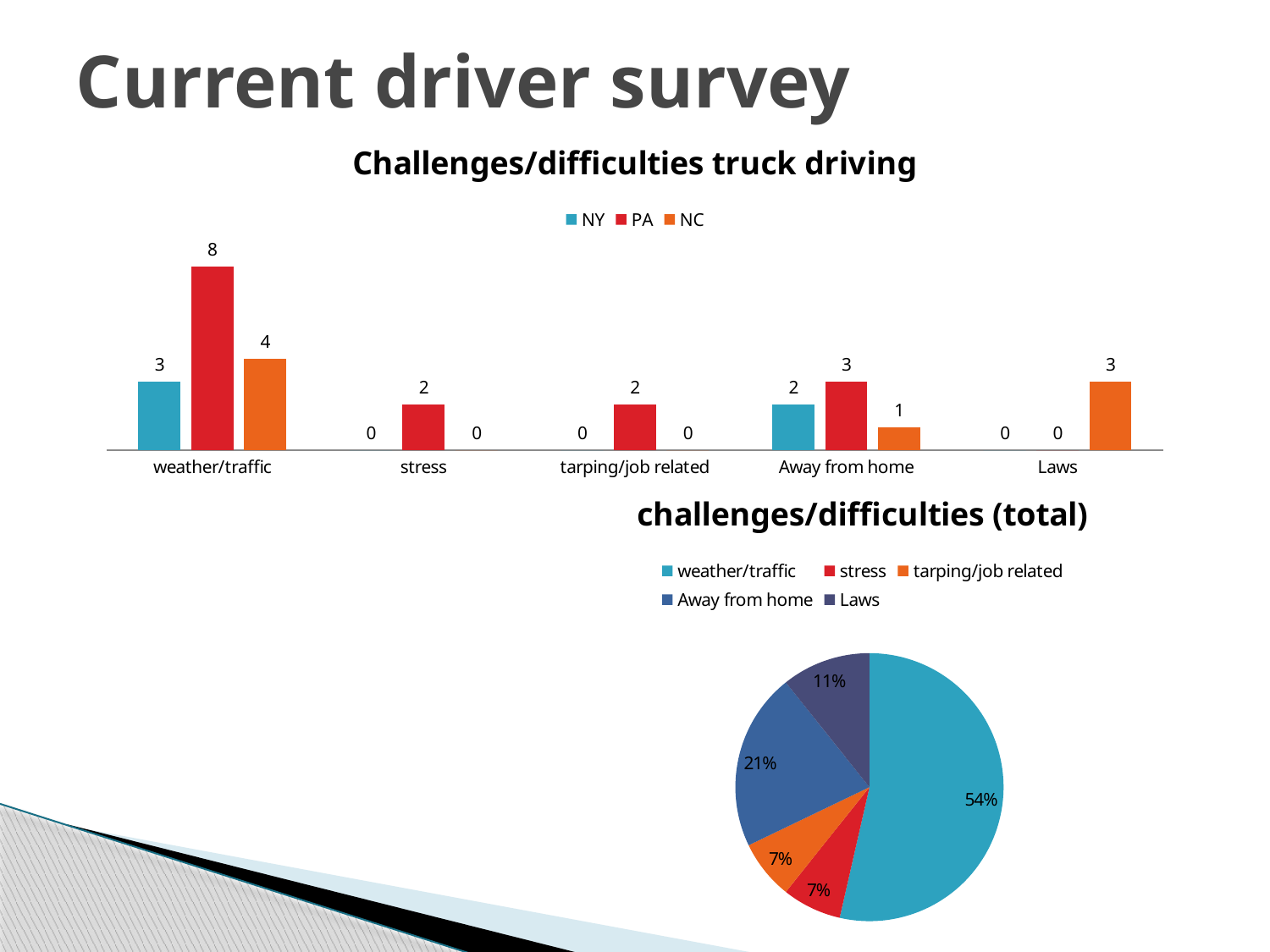
In the 'Challenges/difficulties truck driving' chart, what is the value for NC in the Laws category? 3 In the 'Challenges/difficulties truck driving' chart, which category has the highest PA value? weather/traffic What kind of chart is 'Challenges/difficulties truck driving'? bar chart In the 'Challenges/difficulties truck driving' chart, which is larger for Away from home: the PA value or the NC value? PA In the 'Challenges/difficulties truck driving' chart, what is the value for NY in the Away from home category? 2 What kind of chart is 'challenges/difficulties (total)'? pie chart In the 'challenges/difficulties (total)' pie chart, what share does Away from home have? 21% In the 'Challenges/difficulties truck driving' chart, what is the difference between the PA and NY values for weather/traffic? 5 In the 'challenges/difficulties (total)' pie chart, what share does weather/traffic have? 54% How many series does the legend of the 'Challenges/difficulties truck driving' chart list? 3 In the 'Challenges/difficulties truck driving' chart, what is the value for PA in the weather/traffic category? 8 How many categories are shown on the x axis of the 'Challenges/difficulties truck driving' chart? 5